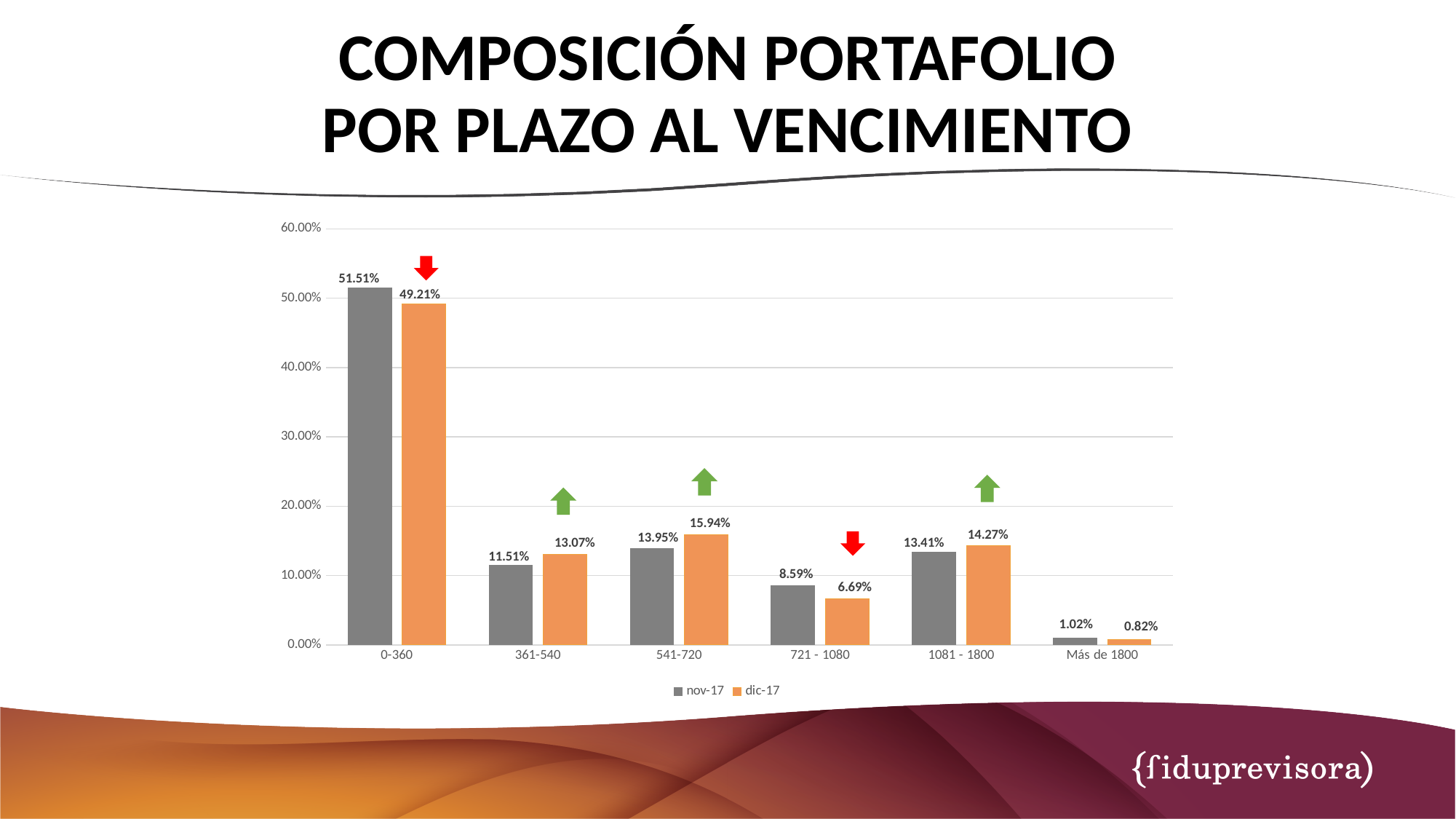
How many series does the legend list? 2 Which is larger for the 1081 - 1800 category, the nov-17 value or the dic-17 value? dic-17 What is the dic-17 value for the 541-720 category? 15.94% What kind of chart is shown on the slide? Bar chart What is the dic-17 value for the 0-360 category? 49.21% What is the nov-17 value for the 721 - 1080 category? 8.59% Which colour represents the dic-17 series? Orange Which category has the highest nov-17 value? 0-360 What is the difference between the nov-17 and dic-17 values for the 0-360 category? 2.30 percentage points Which category has the lowest dic-17 value? Más de 1800 Is the nov-17 value for the 361-540 category greater or less than 10.00%? greater How many categories are shown on the x axis? 6